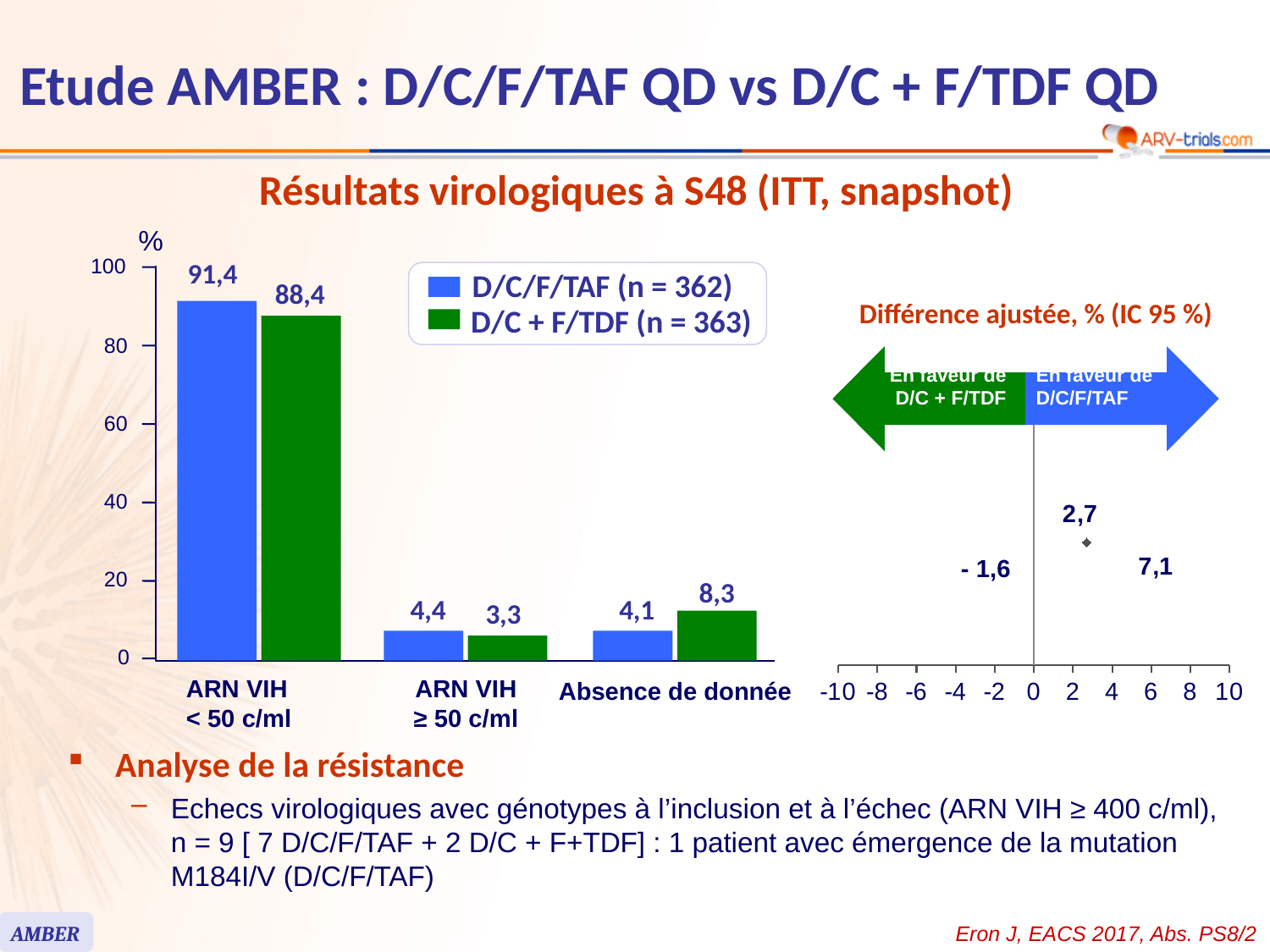
What kind of chart is shown on the left of the slide? Bar chart In the bar chart on the left, which category has the lowest value for D/C + F/TDF? ARN VIH ≥ 50 c/ml In the bar chart on the left, what is the difference between the D/C/F/TAF and D/C + F/TDF values in the ARN VIH < 50 c/ml category? 3,0 In the bar chart on the left, what is the value for D/C + F/TDF in the ARN VIH < 50 c/ml category? 88,4 In the bar chart on the left, which category has the highest value for D/C/F/TAF? ARN VIH < 50 c/ml In the bar chart on the left, what is the value for D/C + F/TDF in the Absence de donnée category? 8,3 In the bar chart on the left, what is the value for D/C/F/TAF in the ARN VIH ≥ 50 c/ml category? 4,4 In the bar chart on the left, which series has the larger value in the Absence de donnée category? D/C + F/TDF In the bar chart on the left, how many categories are shown on the x axis? 3 In the chart on the right titled 'Différence ajustée, % (IC 95 %)', what is the point estimate of the adjusted difference? 2,7 In the bar chart on the left, how many series does the legend list? 2 In the bar chart on the left, what is the value for D/C/F/TAF in the ARN VIH < 50 c/ml category? 91,4